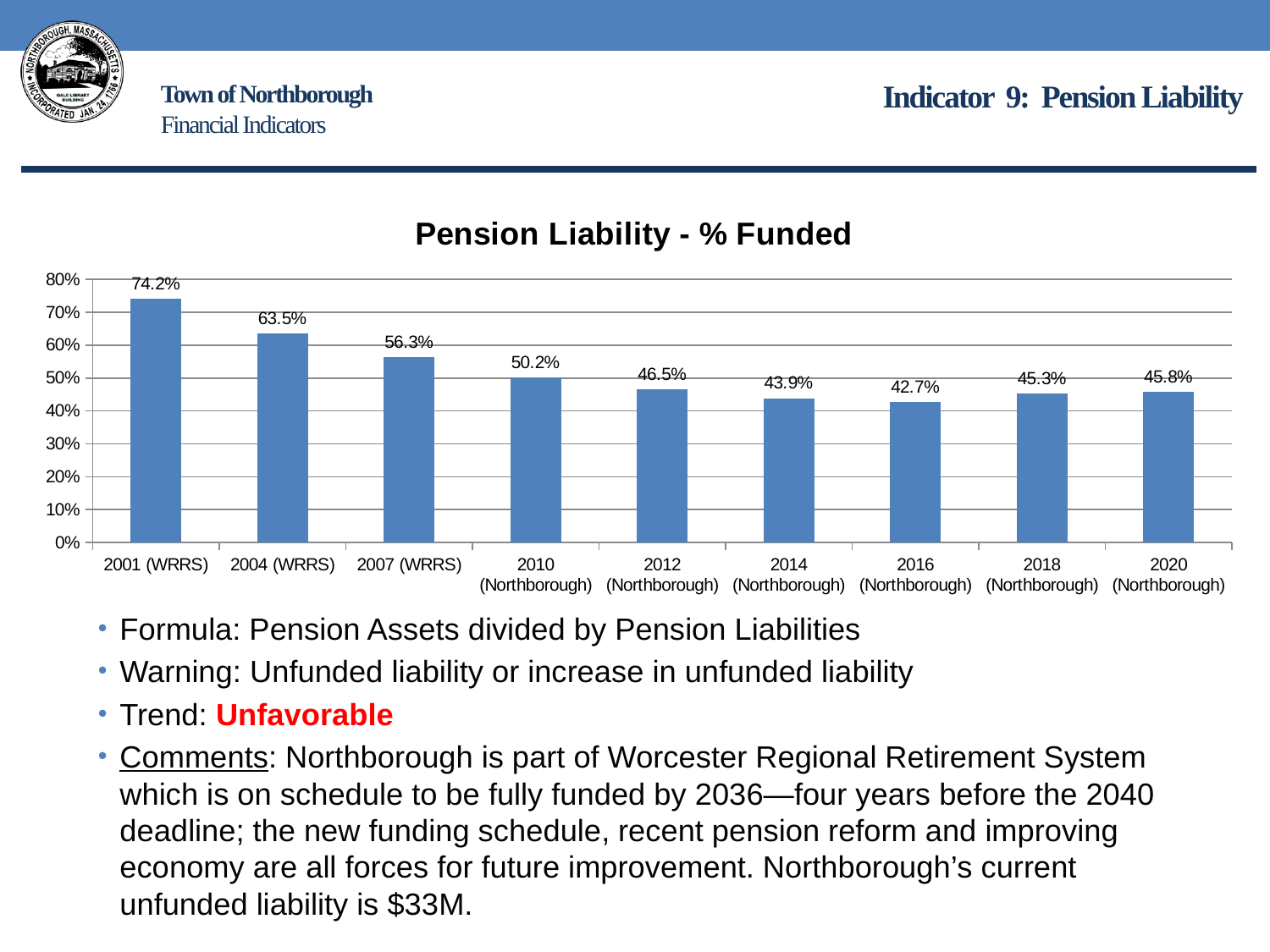
What is the difference in % funded between 2001 (WRRS) and 2004 (WRRS)? 10.7% What is the pension liability % funded for 2020 (Northborough)? 45.8% What is the title of the chart? Pension Liability - % Funded Which has a higher % funded, 2010 (Northborough) or 2012 (Northborough)? 2010 (Northborough) Is the value for 2007 (WRRS) greater or less than 50%? greater What kind of chart is shown on the slide? Bar chart What is the difference in % funded between 2020 (Northborough) and 2018 (Northborough)? 0.5% What is the pension liability % funded for 2001 (WRRS)? 74.2% Which category has the lowest % funded? 2016 (Northborough) What is the pension liability % funded for 2016 (Northborough)? 42.7% Which category has the highest % funded? 2001 (WRRS) How many categories are shown on the x axis? 9